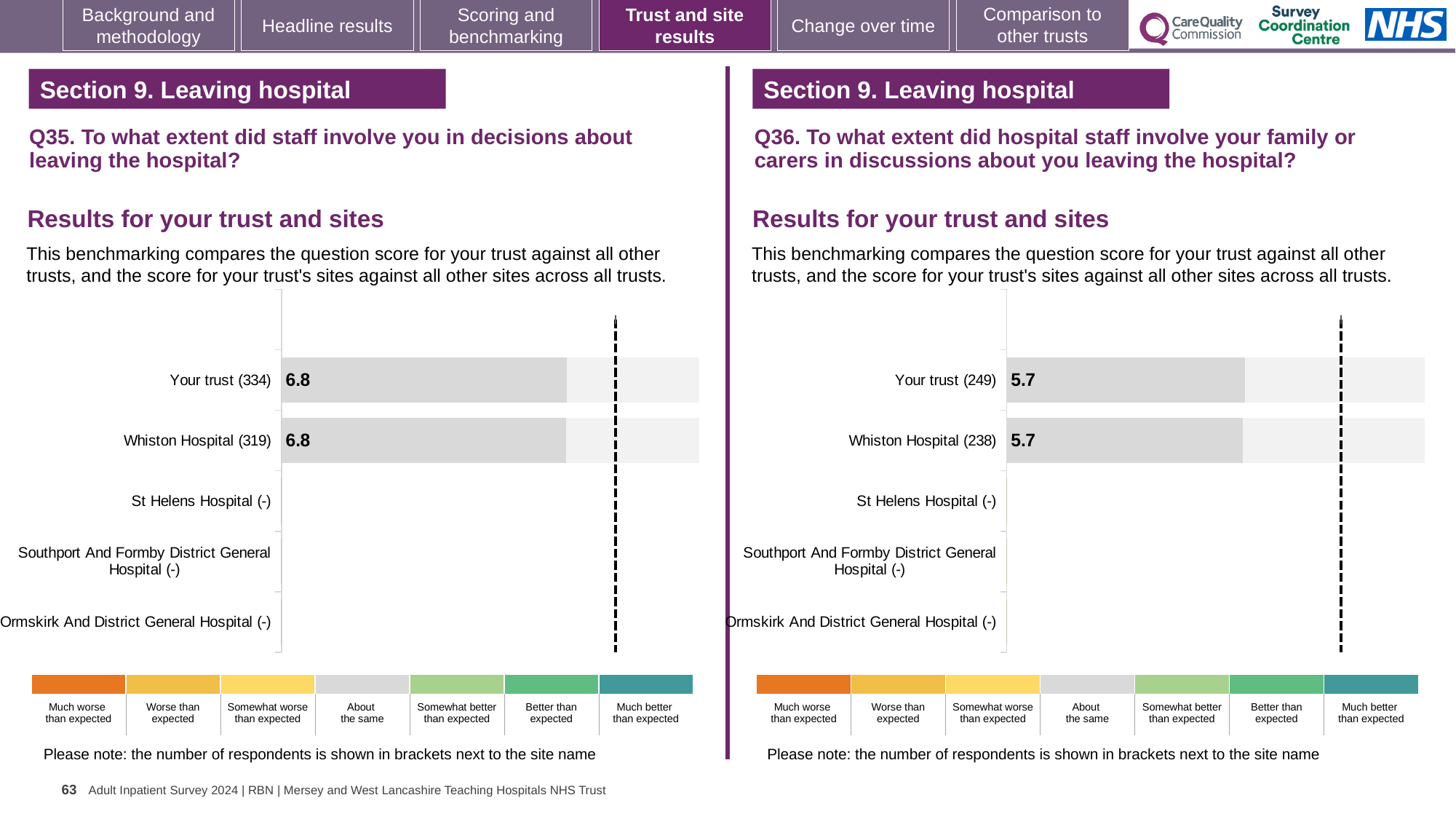
In the Q35 chart on the left, what is the score for Whiston Hospital? 6.8 Is the Your trust score higher in the Q35 chart on the left or the Q36 chart on the right? Q35 chart on the left What kind of chart is used in the Q35 chart on the left? Bar chart In the Q36 chart on the right, do Your trust and Whiston Hospital have the same score? Yes In the Q36 chart on the right, how many respondents are shown in brackets for Whiston Hospital? 238 In the Q35 chart on the left, what is the score for Your trust? 6.8 In the Q36 chart on the right, what is the score for Whiston Hospital? 5.7 How many sites or categories are listed on the y axis of the Q35 chart on the left? 5 In the Q35 chart on the left, how many respondents are shown in brackets for Your trust? 334 What is the difference between the Your trust score in the Q35 chart on the left and the Your trust score in the Q36 chart on the right? 1.1 In the Q36 chart on the right, what is the score for Your trust? 5.7 How many sites or categories are listed on the y axis of the Q36 chart on the right? 5